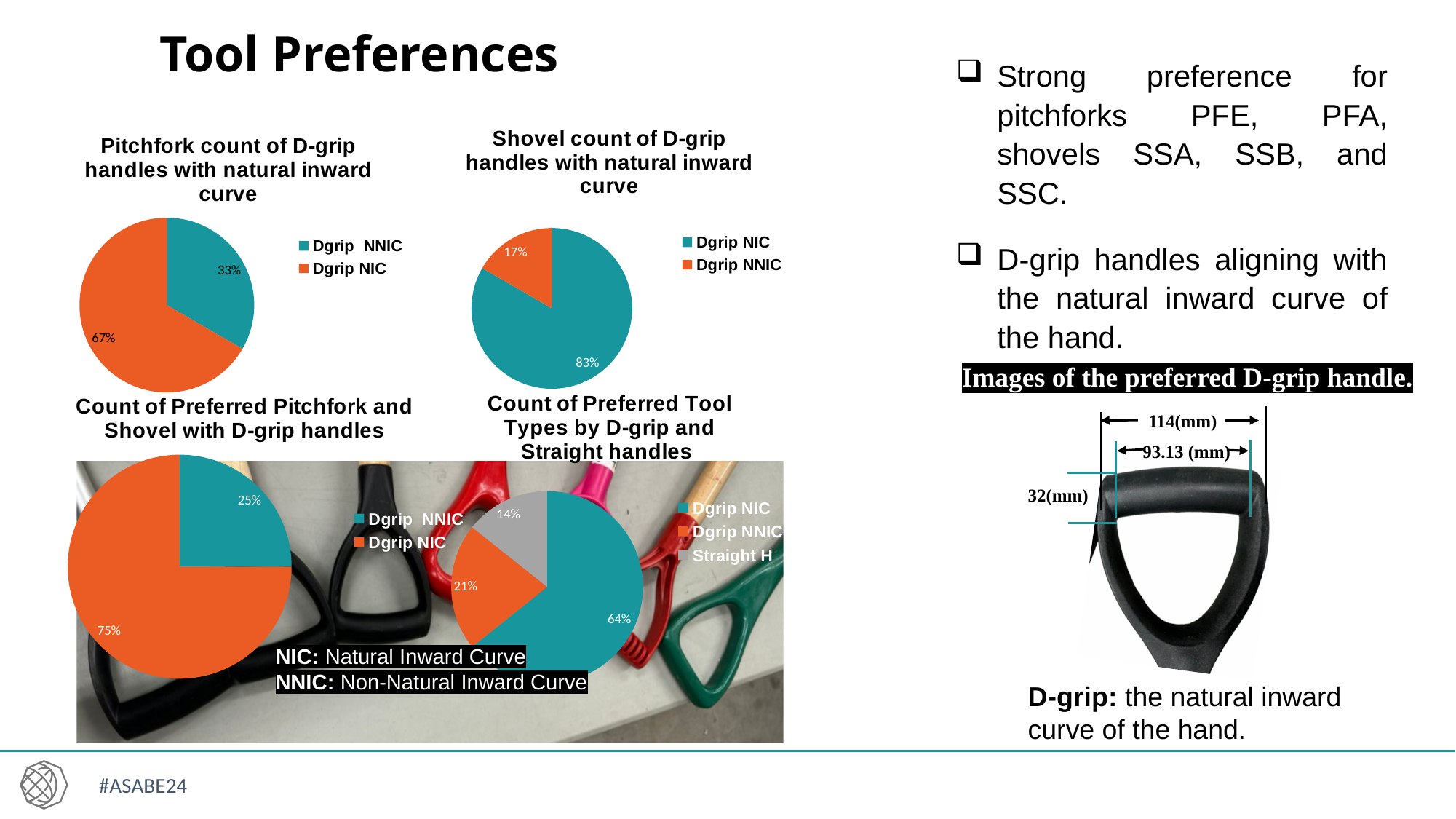
In the 'Count of Preferred Pitchfork and Shovel with D-grip handles' chart, which category has the largest slice? Dgrip NIC In the 'Count of Preferred Tool Types by D-grip and Straight handles' chart, which is larger, Dgrip NNIC or Straight H? Dgrip NNIC In the 'Pitchfork count of D-grip handles with natural inward curve' chart, what percentage is shown for Dgrip NNIC? 33% In the 'Pitchfork count of D-grip handles with natural inward curve' chart, what share of the pie is Dgrip NIC? 67% In the 'Shovel count of D-grip handles with natural inward curve' chart, what percentage is shown for Dgrip NNIC? 17% In the 'Count of Preferred Pitchfork and Shovel with D-grip handles' chart, what is the difference in percentage points between Dgrip NIC and Dgrip NNIC? 50 In the 'Shovel count of D-grip handles with natural inward curve' chart, what share of the pie is Dgrip NIC? 83% In the 'Count of Preferred Tool Types by D-grip and Straight handles' chart, what percentage is shown for Straight H? 14% In the 'Count of Preferred Tool Types by D-grip and Straight handles' chart, how many categories does the legend list? 3 What kind of chart is the 'Shovel count of D-grip handles with natural inward curve' chart? Pie chart In the 'Count of Preferred Tool Types by D-grip and Straight handles' chart, which category has the smallest slice? Straight H How many pie charts are shown on the slide? 4